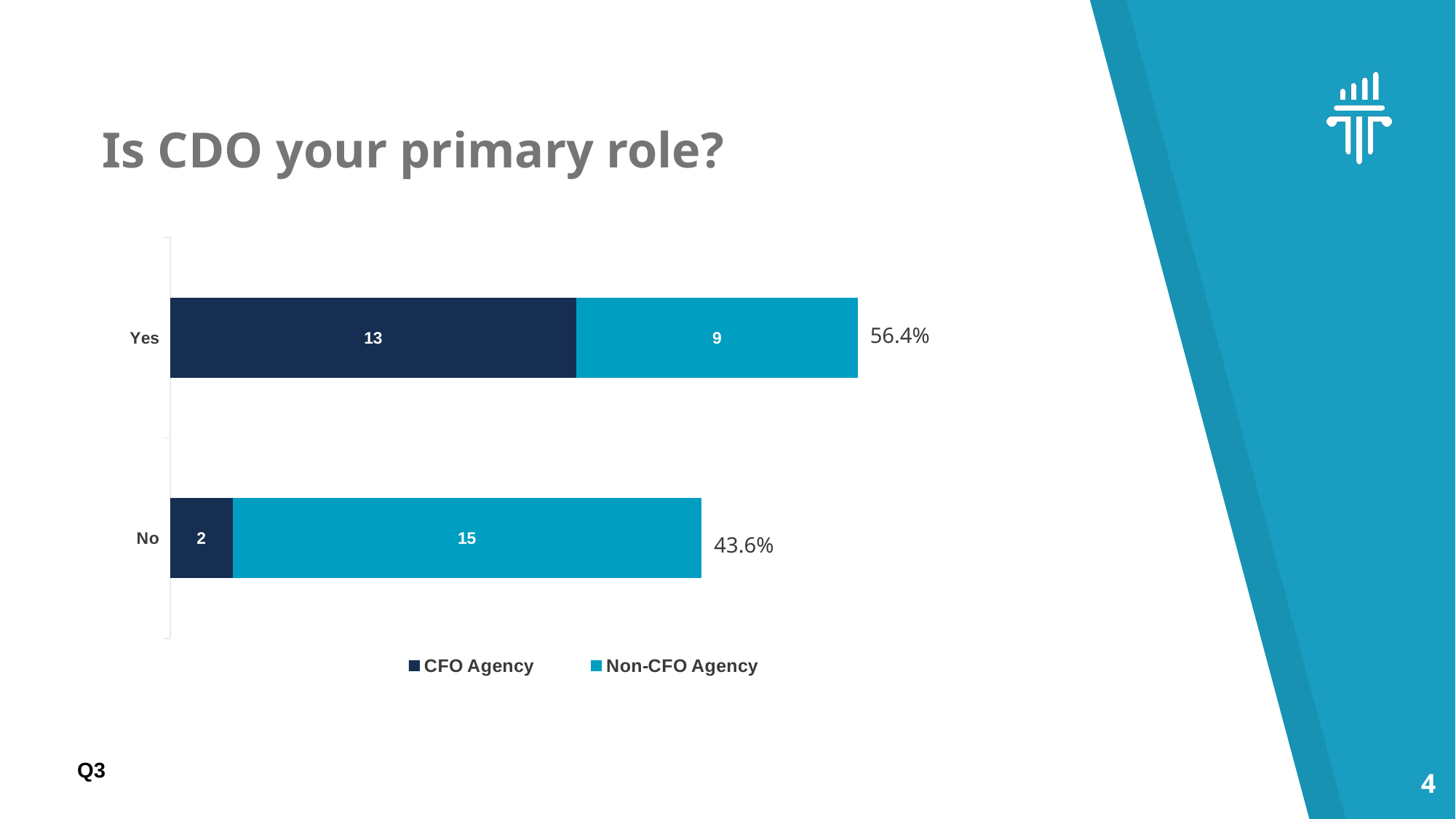
What is the total of the stacked bar for No? 17 What is the value for Non-CFO Agency in the Yes category? 9 What is the value for CFO Agency in the No category? 2 What is the difference between the Non-CFO Agency values for No and Yes? 6 What is the value for Non-CFO Agency in the No category? 15 Which is larger, the CFO Agency value for Yes or the CFO Agency value for No? Yes How many series does the legend list? 2 What percentage is shown next to the No bar? 43.6% What kind of chart is shown on the slide? Stacked bar chart What is the total of the stacked bar for Yes? 22 What is the value for CFO Agency in the Yes category? 13 What percentage is shown next to the Yes bar? 56.4%